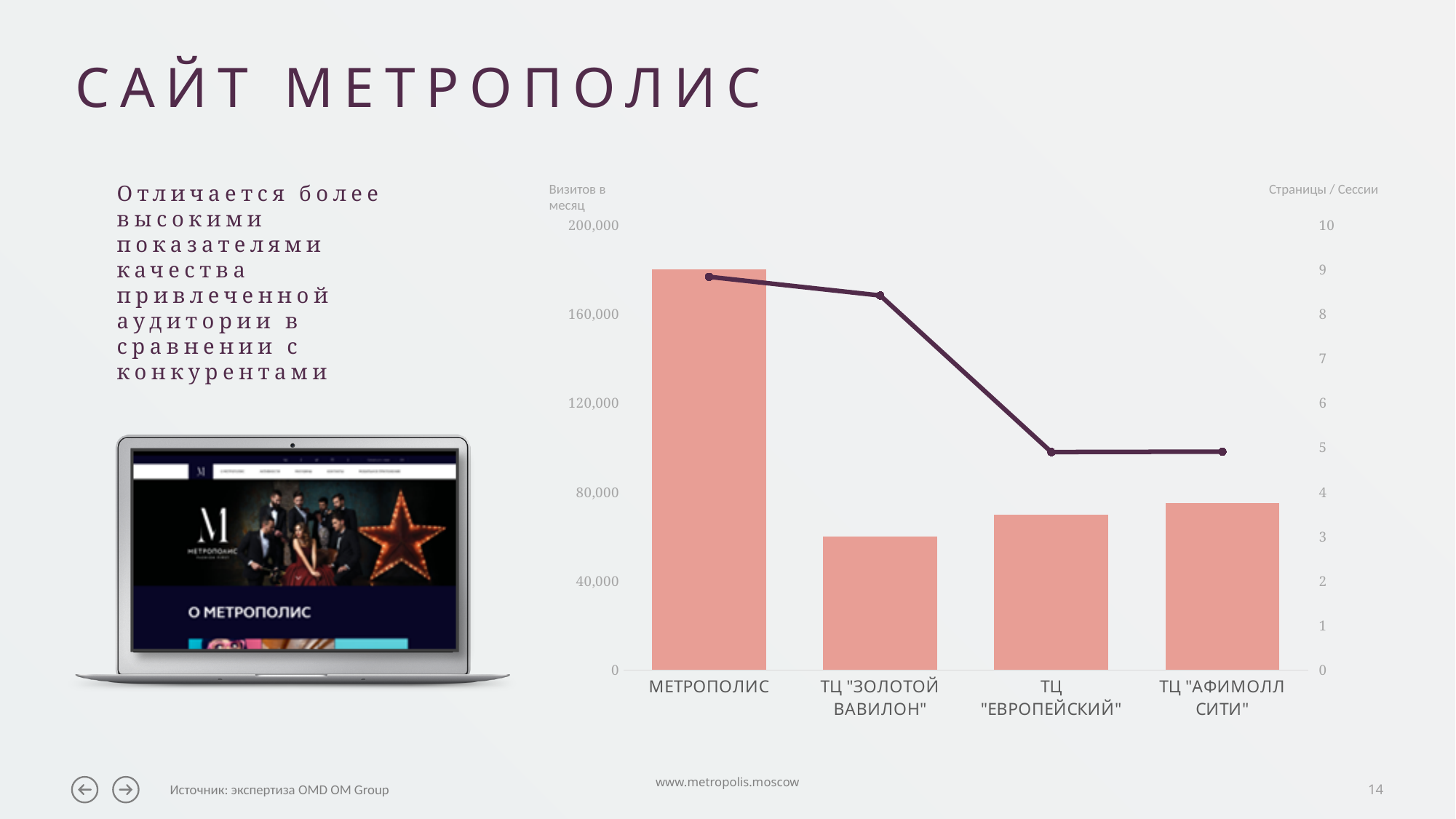
Does the line for pages per session (Страницы / Сессии) rise or fall from МЕТРОПОЛИС to ТЦ "ЕВРОПЕЙСКИЙ"? fall What is the title of the left vertical axis of the chart? Визитов в месяц Which category has the lowest bar for visits per month (Визитов в месяц)? ТЦ "ЗОЛОТОЙ ВАВИЛОН" Is the bar for ТЦ "ЗОЛОТОЙ ВАВИЛОН" greater or less than 80,000 visits per month? less Is the pages-per-session value (Страницы / Сессии) for МЕТРОПОЛИС greater or less than 8? greater Which category has the highest bar for visits per month (Визитов в месяц)? МЕТРОПОЛИС Is the bar for МЕТРОПОЛИС greater or less than 160,000 visits per month? greater Which has more visits per month: МЕТРОПОЛИС or ТЦ "АФИМОЛЛ СИТИ"? МЕТРОПОЛИС What kind of chart is shown on the slide? Combined bar and line chart How many categories (shopping centres) are shown on the x axis of the chart? 4 Which has more visits per month: ТЦ "ЕВРОПЕЙСКИЙ" or ТЦ "ЗОЛОТОЙ ВАВИЛОН"? ТЦ "ЕВРОПЕЙСКИЙ"